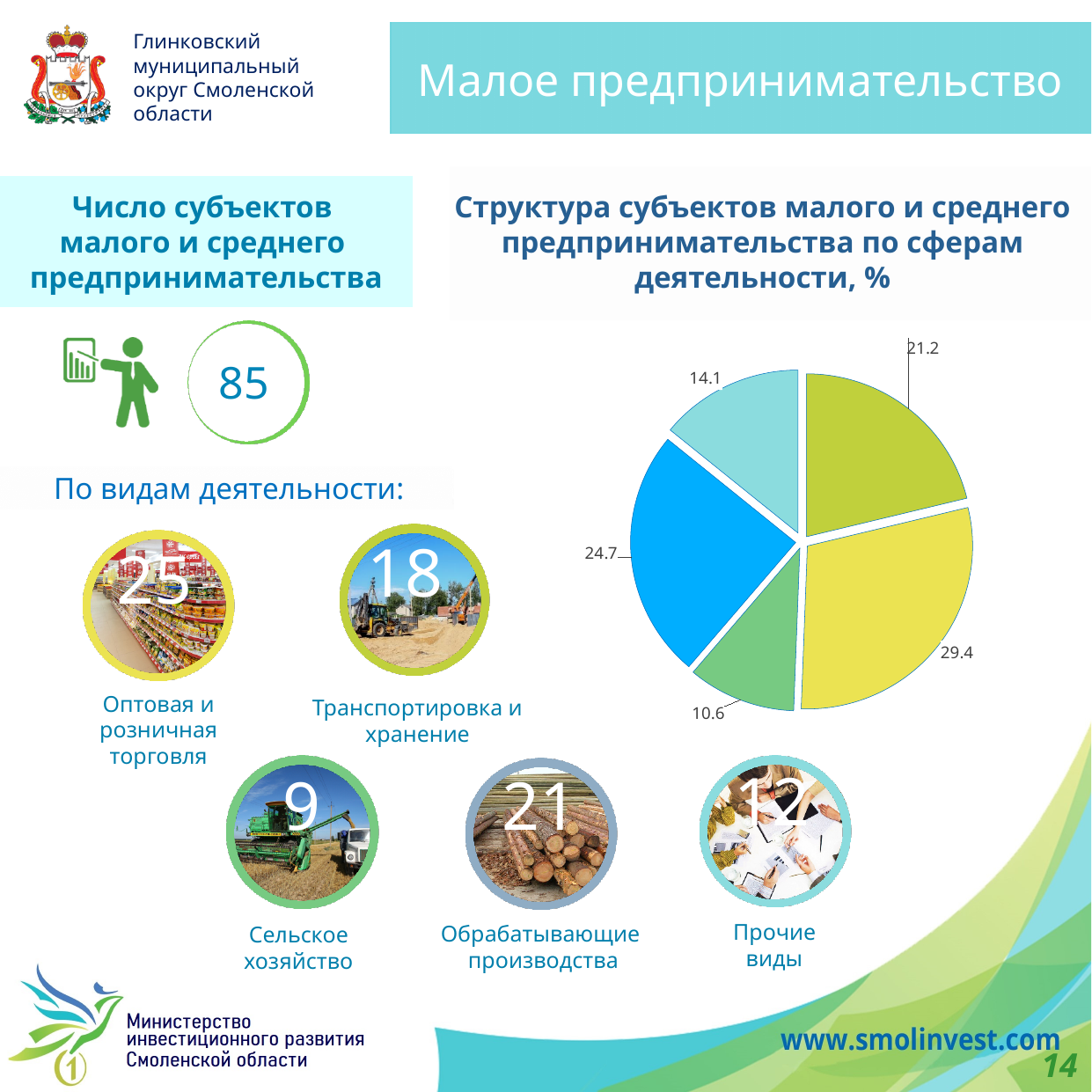
What is the value of the large yellow slice on the right of the pie chart? 29.4 What is the smallest value shown on the pie chart? 10.6 What is the value of the blue slice on the left of the pie chart? 24.7 What is the largest value shown on the pie chart? 29.4 What is the value of the light cyan slice at the top left of the pie chart? 14.1 What kind of chart is shown on the slide? pie chart What is the difference between the slices labelled 21.2 and 10.6? 10.6 What is the difference between the largest slice (29.4) and the blue slice (24.7)? 4.7 Which is larger: the slice labelled 21.2 or the slice labelled 14.1? 21.2 How many slices does the pie chart have? 5 What is the total of all the slice values on the pie chart? 100 What is the title of the pie chart? Структура субъектов малого и среднего предпринимательства по сферам деятельности, %